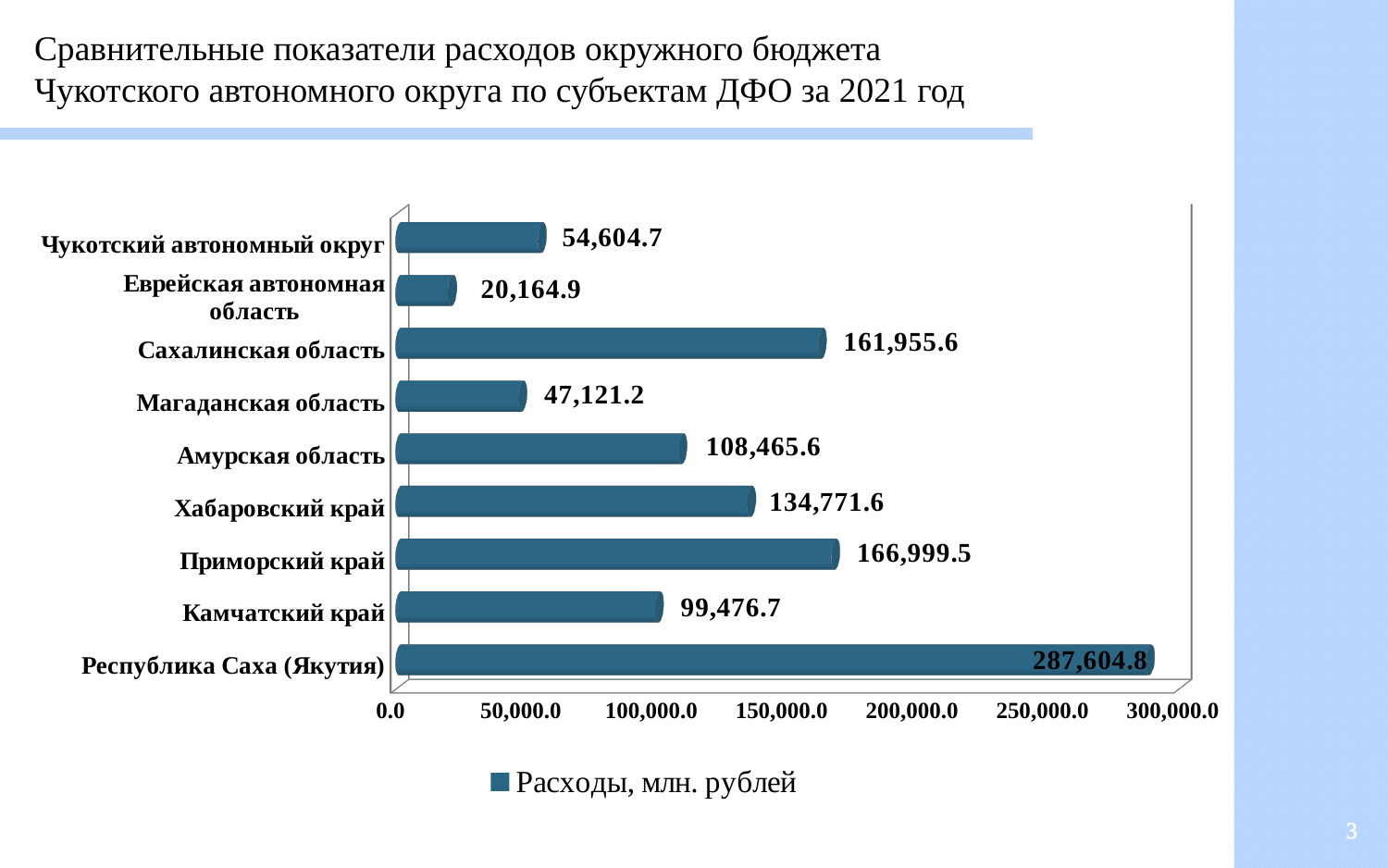
Which region has the lowest value? Еврейская автономная область What is the difference between the values for Приморский край and Сахалинская область? 5,043.9 What is the value for Камчатский край? 99,476.7 What is the value for Чукотский автономный округ? 54,604.7 Which is larger, the value for Хабаровский край or the value for Амурская область? Хабаровский край What is the value for Сахалинская область? 161,955.6 What kind of chart is shown on the slide? bar chart What is the difference between the values for Чукотский автономный округ and Магаданская область? 7,483.5 Is the value for Республика Саха (Якутия) greater or less than 250,000.0? greater Which region has the highest value? Республика Саха (Якутия) How many regions are shown in the chart? 9 What is the legend entry of the chart? Расходы, млн. рублей